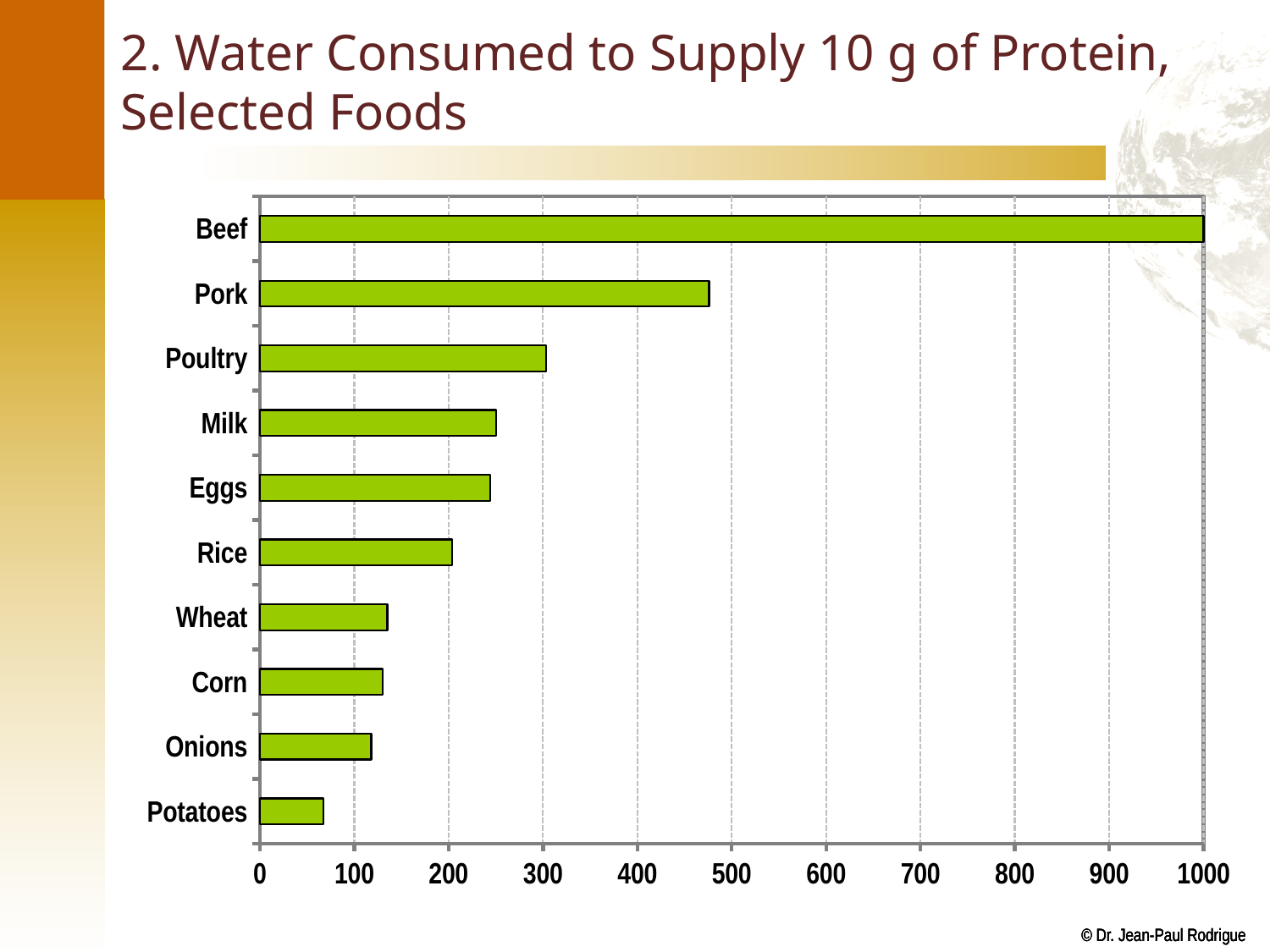
What is the title of the slide containing the chart? 2. Water Consumed to Supply 10 g of Protein, Selected Foods Which food has the highest water consumption to supply 10 g of protein? Beef Which food has the lowest water consumption to supply 10 g of protein? Potatoes How many foods are shown in the chart? 10 Which requires more water to supply 10 g of protein, Rice or Wheat? Rice Is the value for Eggs greater or less than 300? less Is the value for Potatoes greater or less than 100? less What kind of chart is shown on the slide? bar chart Is the value for Pork greater or less than 400? greater Which requires more water to supply 10 g of protein, Pork or Poultry? Pork